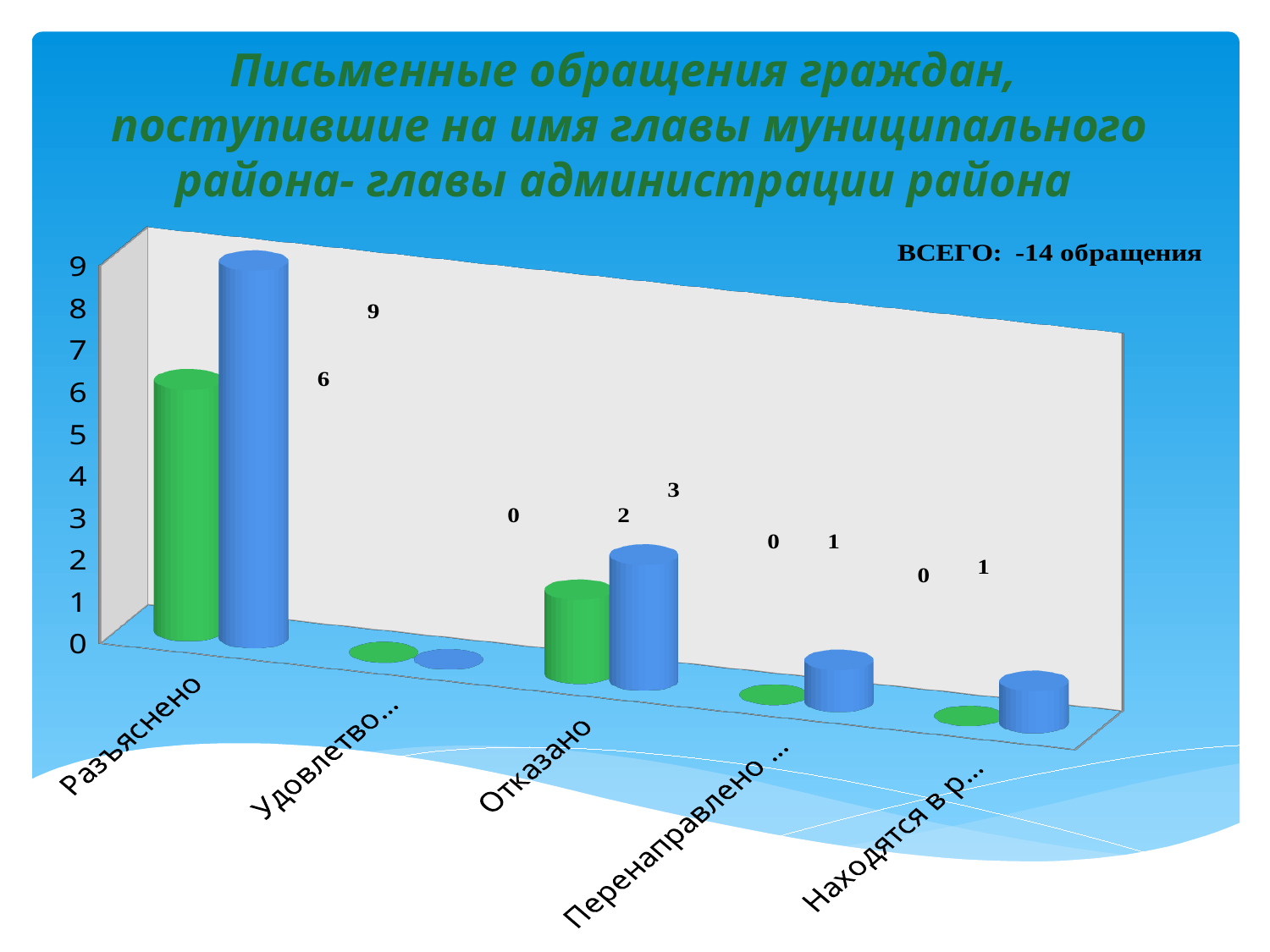
What is the difference between the blue and green bars for Разъяснено? 3 What total number of appeals (ВСЕГО) is stated on the slide? 14 обращения How many categories are shown on the x axis? 5 What is the value of the green bar for Отказано? 2 What is the value of the blue bar for Отказано? 3 What is the value of the green bar for Разъяснено? 6 What kind of chart is shown on the slide? bar chart What is the difference between the blue bar for Разъяснено and the blue bar for Отказано? 6 What is the value of the blue bar for Разъяснено? 9 What is the value of the blue bar for the category labelled Перенаправлено ...? 1 For Отказано, which bar is larger, the blue one or the green one? blue Which category has the highest blue bar? Разъяснено